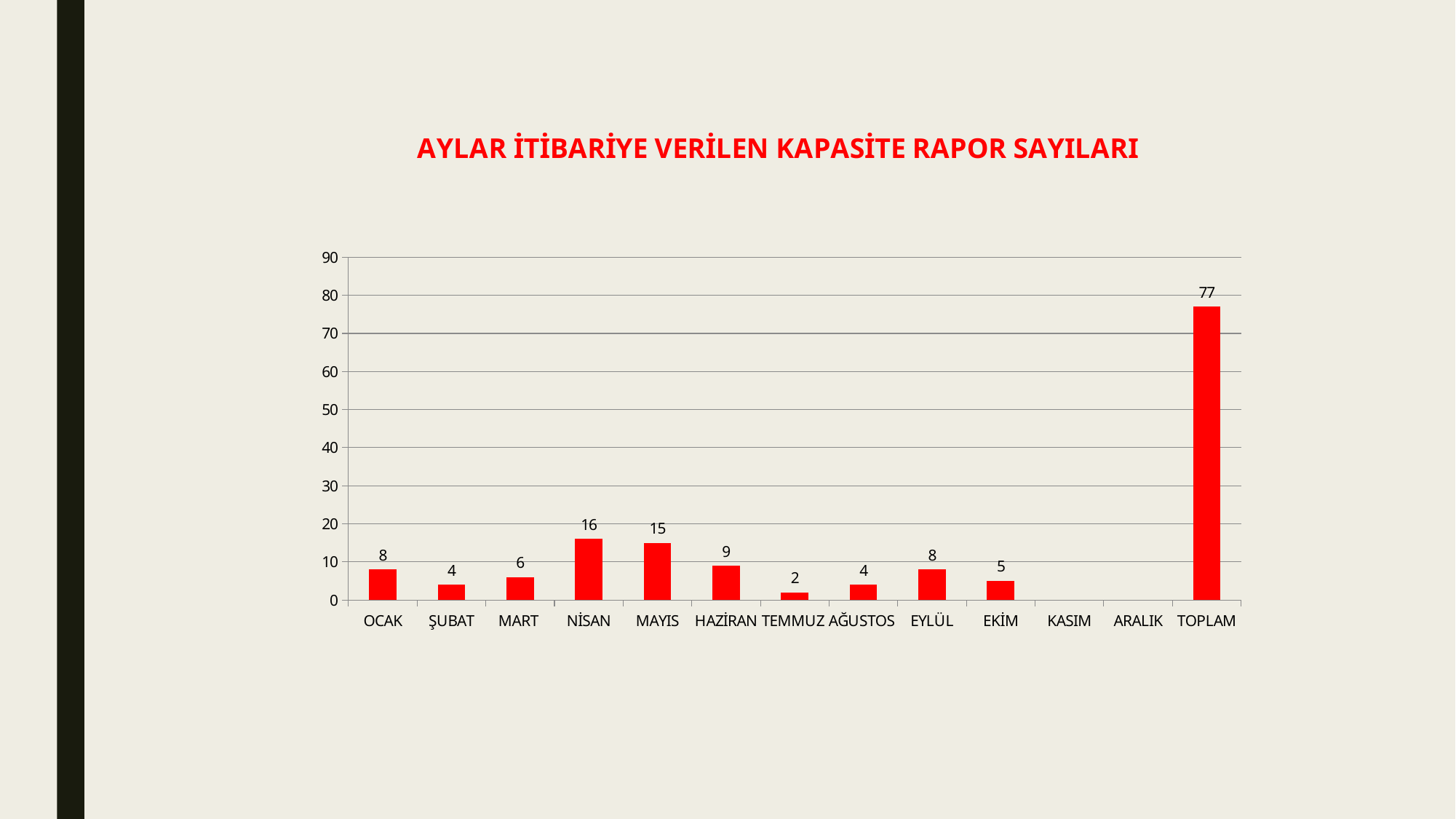
Is the value for TOPLAM greater or less than 70? greater What is the value for NİSAN? 16 What is the value for TEMMUZ? 2 How many categories are shown on the x axis? 13 Among the months that have a labelled bar, which has the lowest value? TEMMUZ What is the difference between the values for TOPLAM and NİSAN? 61 Which is larger, the value for MART or the value for EKİM? MART What type of chart is shown on the slide? Bar chart What is the value for TOPLAM? 77 Excluding the TOPLAM bar, which month has the highest value? NİSAN What is the value for HAZİRAN? 9 What is the difference between the values for NİSAN and MAYIS? 1